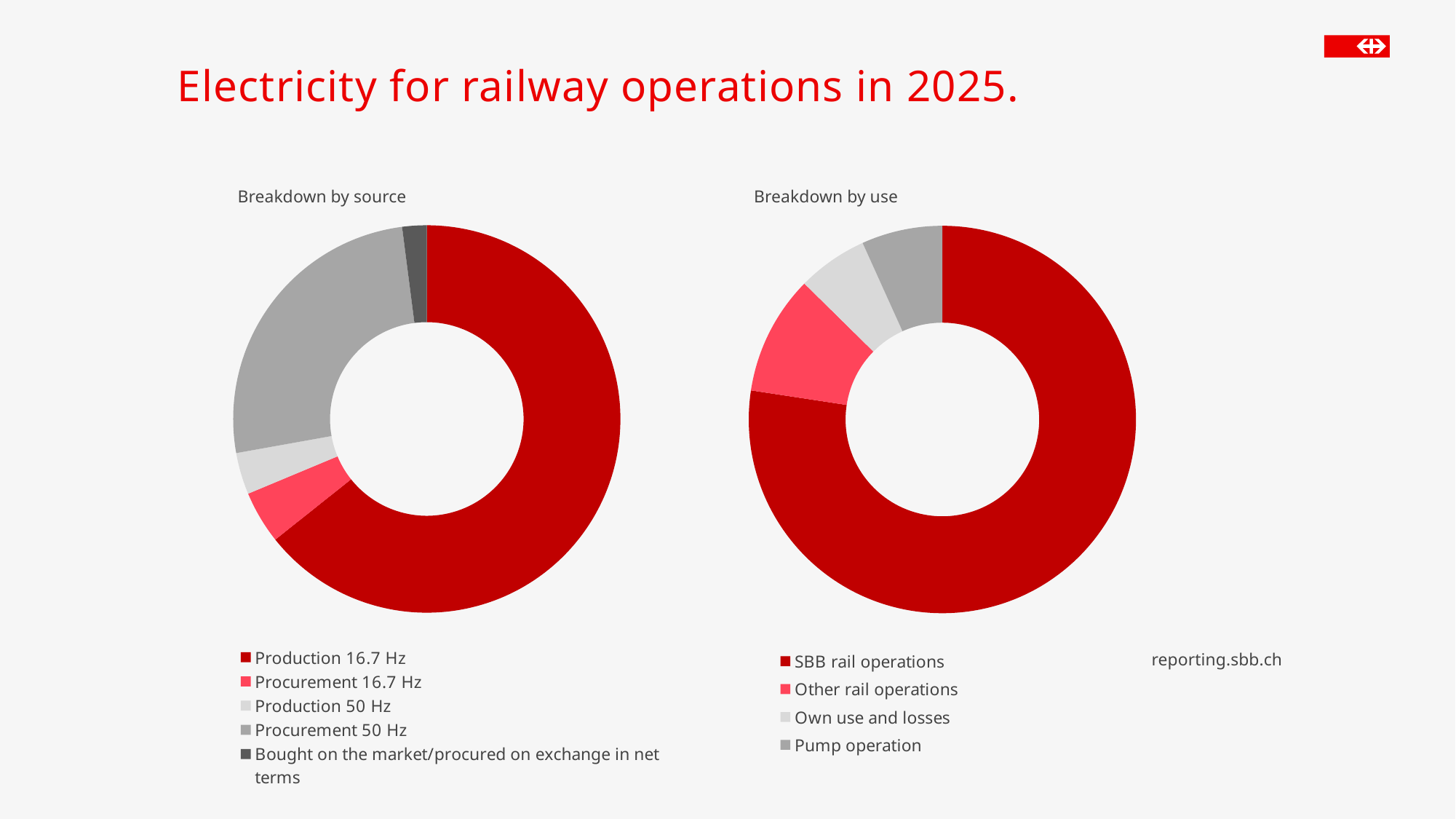
What kind of chart is the "Breakdown by source" chart? Pie chart (doughnut) In the "Breakdown by use" chart, what colour is the SBB rail operations slice? Dark red What kind of chart is the "Breakdown by use" chart? Pie chart (doughnut) In the "Breakdown by source" chart, which category has the smallest share? Bought on the market/procured on exchange in net terms In the "Breakdown by use" chart, how many categories does the legend list? 4 In the "Breakdown by use" chart, which category has the largest share? SBB rail operations In the "Breakdown by source" chart, which is larger: Production 16.7 Hz or Procurement 50 Hz? Production 16.7 Hz In the "Breakdown by use" chart, which is larger: SBB rail operations or Other rail operations? SBB rail operations What is the title of the slide? Electricity for railway operations in 2025. In the "Breakdown by source" chart, which is larger: Procurement 50 Hz or Procurement 16.7 Hz? Procurement 50 Hz In the "Breakdown by source" chart, which category has the largest share? Production 16.7 Hz In the "Breakdown by source" chart, how many categories does the legend list? 5